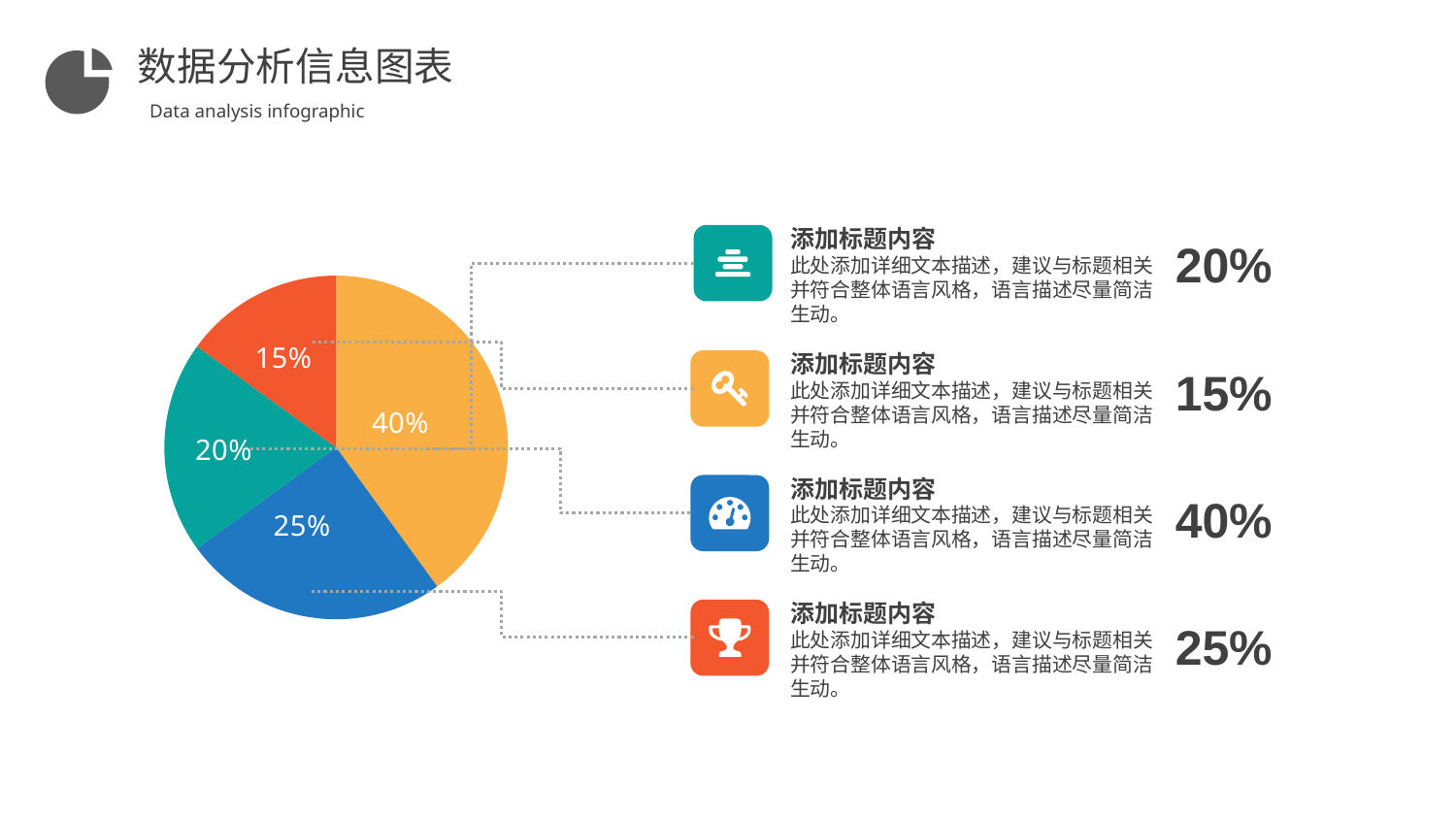
What percentage is shown on the red slice of the pie chart? 15% What is the difference between the orange slice and the blue slice of the pie chart? 15% How many slices does the pie chart have? 4 What percentage is shown on the orange slice of the pie chart? 40% What share of the pie do the orange and blue slices make up together? 65% What percentage is shown on the teal (green) slice of the pie chart? 20% Which slice of the pie chart is the largest? the orange slice (40%) What kind of chart is shown on the slide? pie chart Which is larger in the pie chart, the teal slice or the red slice? the teal slice What is the title of the slide containing the pie chart? 数据分析信息图表 Which slice of the pie chart is the smallest? the red slice (15%) What percentage is shown on the blue slice of the pie chart? 25%